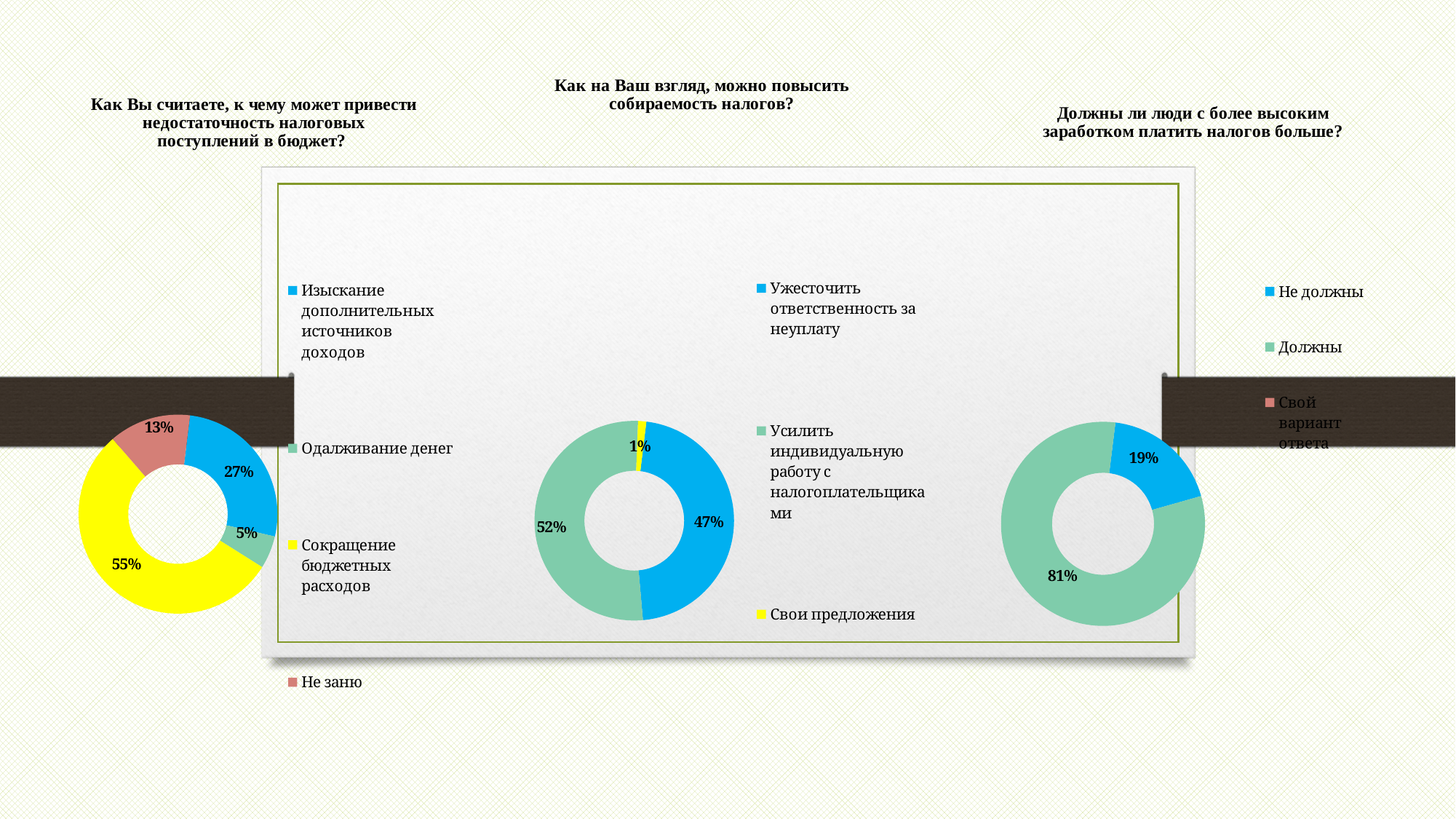
In the left chart ("Как Вы считаете, к чему может привести недостаточность налоговых поступлений в бюджет?"), what share is shown for "Сокращение бюджетных расходов"? 55% In the left chart ("Как Вы считаете, к чему может привести недостаточность налоговых поступлений в бюджет?"), what share is shown for "Одалживание денег"? 5% In the left chart ("Как Вы считаете, к чему может привести недостаточность налоговых поступлений в бюджет?"), what is the difference between the shares for "Изыскание дополнительных источников доходов" and "Не заню"? 14% In the left chart ("Как Вы считаете, к чему может привести недостаточность налоговых поступлений в бюджет?"), which category has the largest share? Сокращение бюджетных расходов In the right chart ("Должны ли люди с более высоким заработком платить налогов больше?"), what is the difference between the shares for "Должны" and "Не должны"? 62% In the left chart ("Как Вы считаете, к чему может привести недостаточность налоговых поступлений в бюджет?"), what colour represents "Не заню"? Red What kind of chart is the left chart ("Как Вы считаете, к чему может привести недостаточность налоговых поступлений в бюджет?")? Doughnut chart In the middle chart ("Как на Ваш взгляд, можно повысить собираемость налогов?"), which is larger: "Усилить индивидуальную работу с налогоплательщиками" or "Ужесточить ответственность за неуплату"? Усилить индивидуальную работу с налогоплательщиками In the right chart ("Должны ли люди с более высоким заработком платить налогов больше?"), what share is shown for "Должны"? 81% In the middle chart ("Как на Ваш взгляд, можно повысить собираемость налогов?"), how many categories does the legend list? 3 In the middle chart ("Как на Ваш взгляд, можно повысить собираемость налогов?"), which category has the smallest share? Свои предложения In the middle chart ("Как на Ваш взгляд, можно повысить собираемость налогов?"), what share is shown for "Ужесточить ответственность за неуплату"? 47%